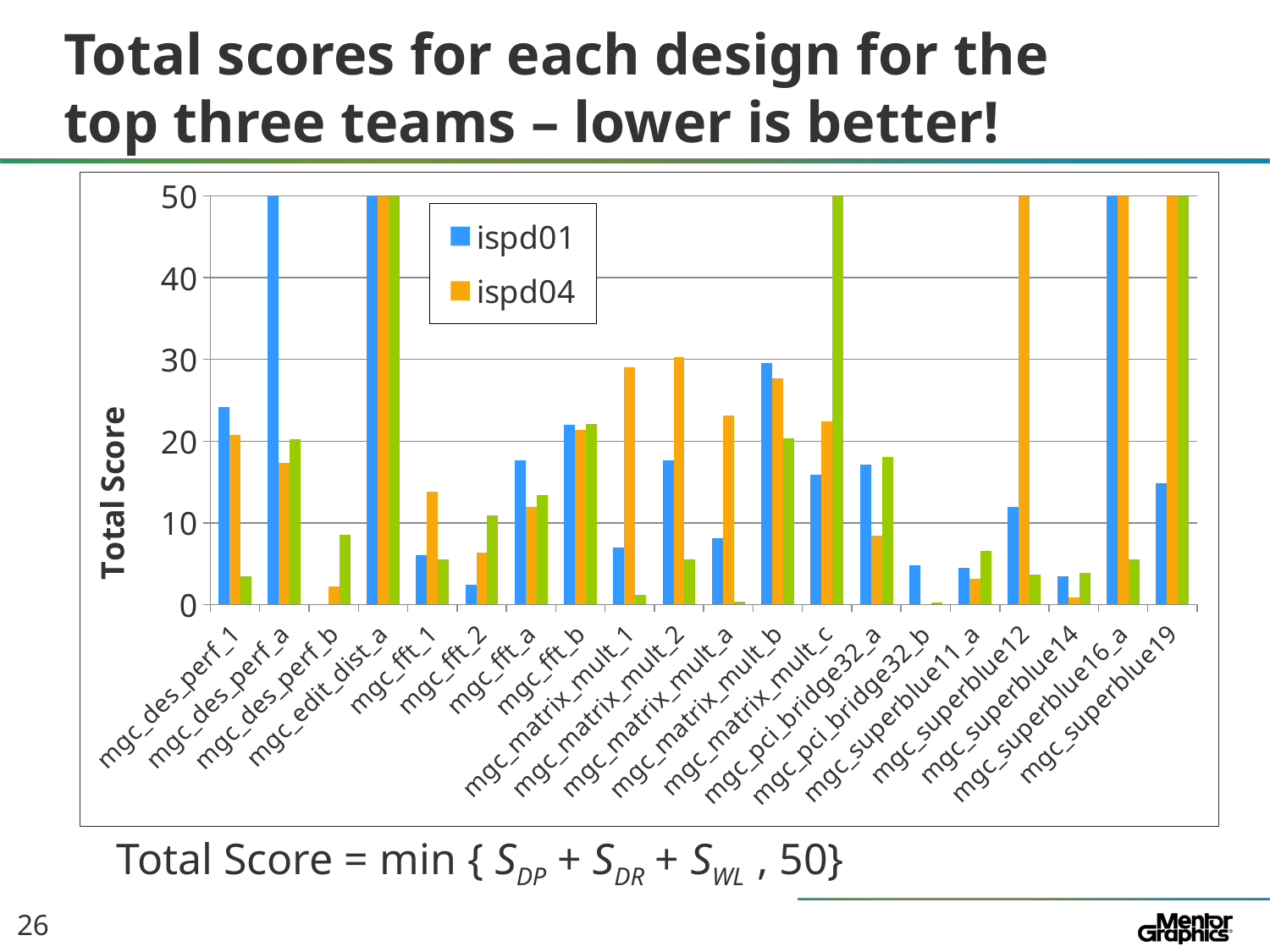
For mgc_fft_a, which series has the larger value, ispd01 or ispd04? ispd01 What is the ispd01 value for mgc_edit_dist_a? 50 How many series does the legend list? 2 What kind of chart is shown on the slide? bar chart What is the ispd01 value for mgc_des_perf_a? 50 How many design categories are shown on the x axis? 20 Is the ispd01 value for mgc_fft_1 greater or less than 10? less What is the title of the y axis? Total Score For mgc_matrix_mult_1, which series has the larger value, ispd01 or ispd04? ispd04 Is the ispd01 value for mgc_des_perf_1 greater or less than 20? greater Is the ispd04 value for mgc_matrix_mult_1 greater or less than 20? greater What is the ispd04 value for mgc_superblue12? 50